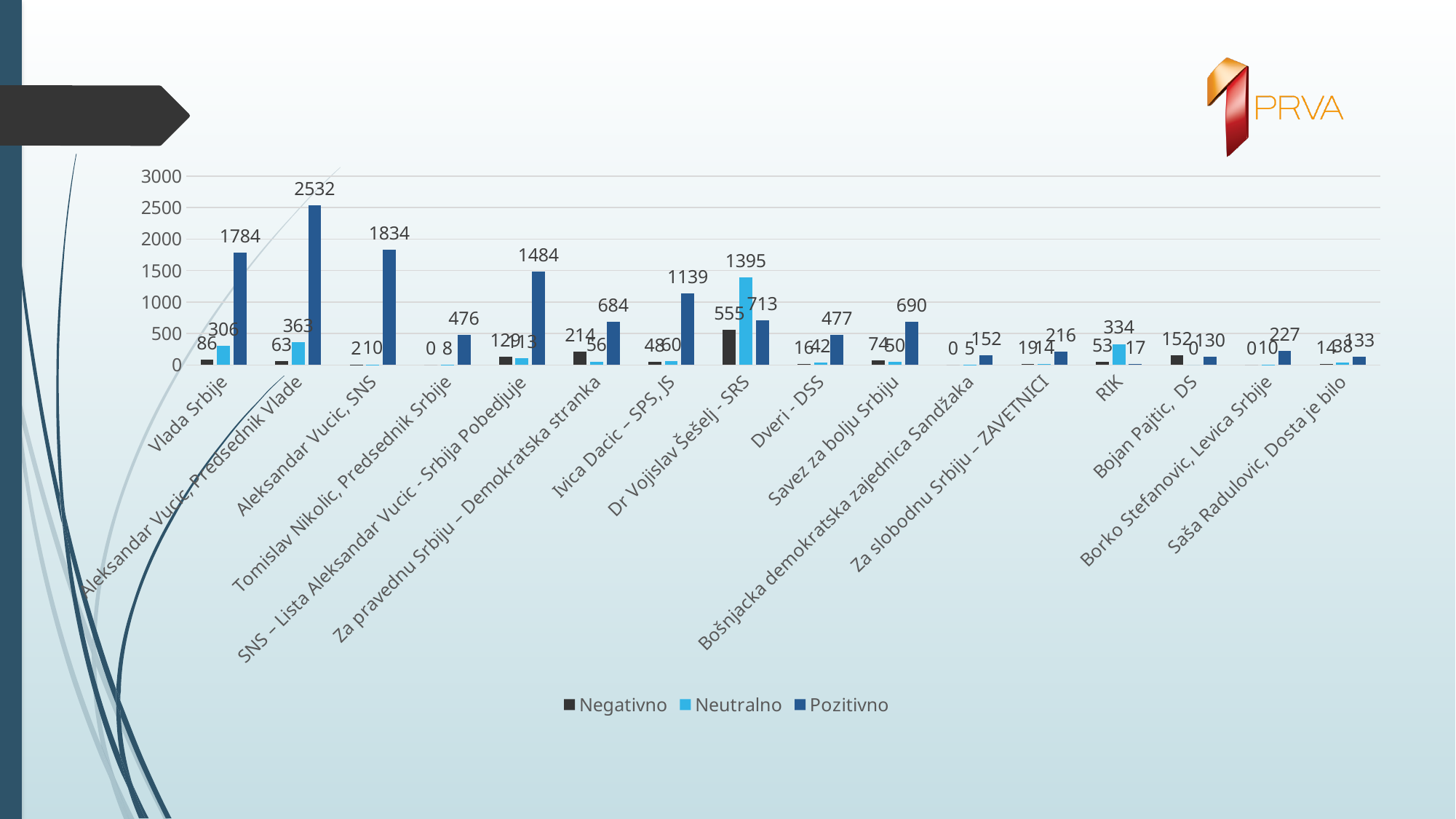
What is the Negativno value for Vlada Srbije? 86 What is the Pozitivno value for Aleksandar Vucic, Predsednik Vlade? 2532 Is the Pozitivno value for Tomislav Nikolic, Predsednik Srbije greater or less than 500? less For Dr Vojislav Šešelj - SRS, which is larger: the Neutralno value or the Pozitivno value? Neutralno Which category has the highest Pozitivno value? Aleksandar Vucic, Predsednik Vlade How many categories are shown on the x axis? 16 What is the total of the three values for RIK? 404 What is the Neutralno value for Dr Vojislav Šešelj - SRS? 1395 How many series does the legend list? 3 Which category has the lowest Pozitivno value? RIK What is the difference between the Pozitivno values for Aleksandar Vucic, Predsednik Vlade and Aleksandar Vucic, SNS? 698 What kind of chart is shown on the slide? bar chart